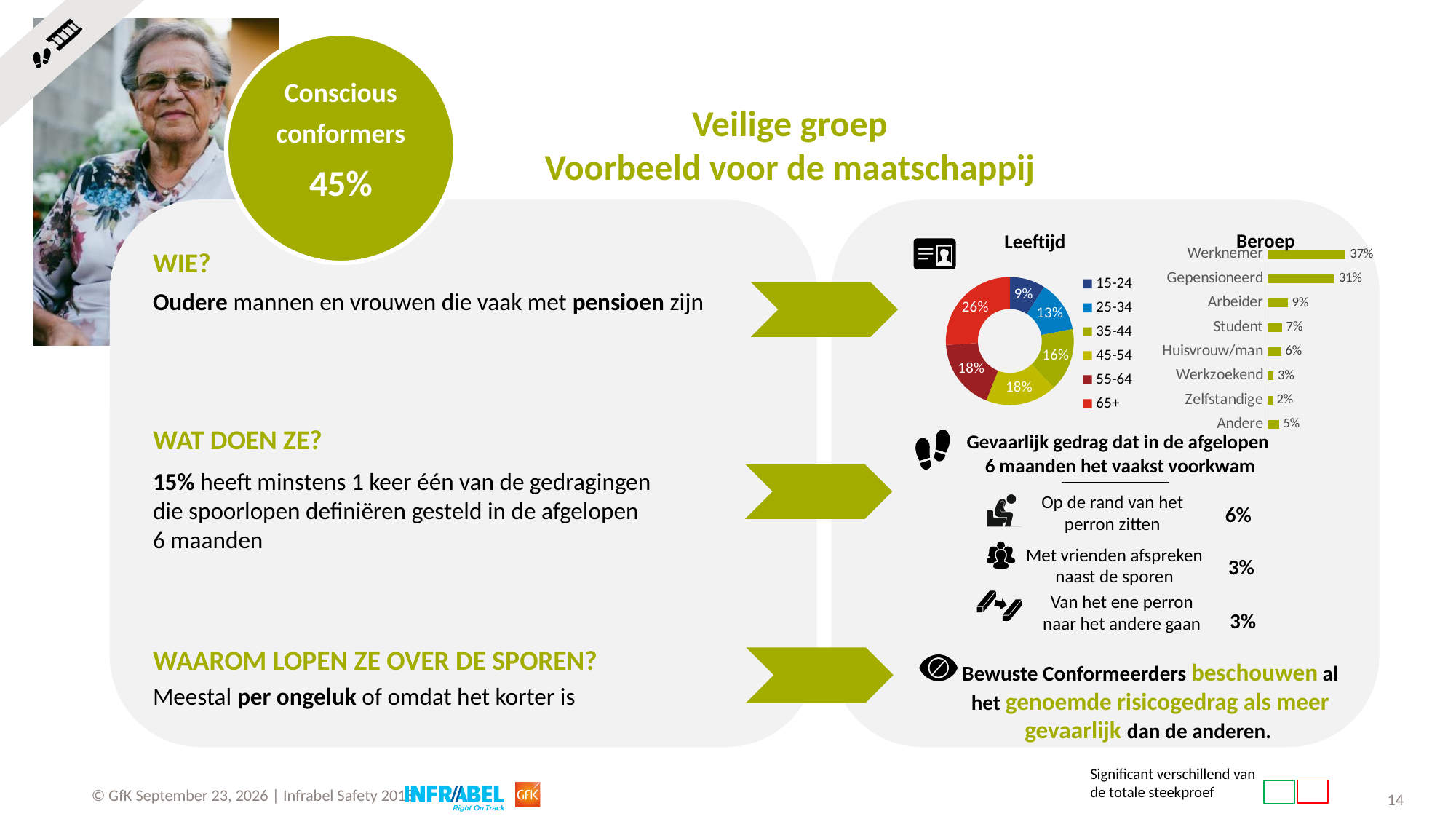
In the Beroep chart, which category has the highest value? Werknemer In the Leeftijd chart, what share is the 65+ age group? 26% In the Beroep chart, what is the value for Zelfstandige? 2% In the Leeftijd chart, how many age groups does the legend list? 6 In the Beroep chart, what is the difference between Werknemer and Gepensioneerd? 6% In the Beroep chart, what is the value for Gepensioneerd? 31% What kind of chart is the Beroep chart? Bar chart In the Leeftijd chart, which age group has the largest share? 65+ What kind of chart is the Leeftijd chart? Donut (pie) chart In the Beroep chart, which is larger: Arbeider or Student? Arbeider In the Leeftijd chart, which age group has the smallest share? 15-24 In the Leeftijd chart, what share is the 15-24 age group? 9%